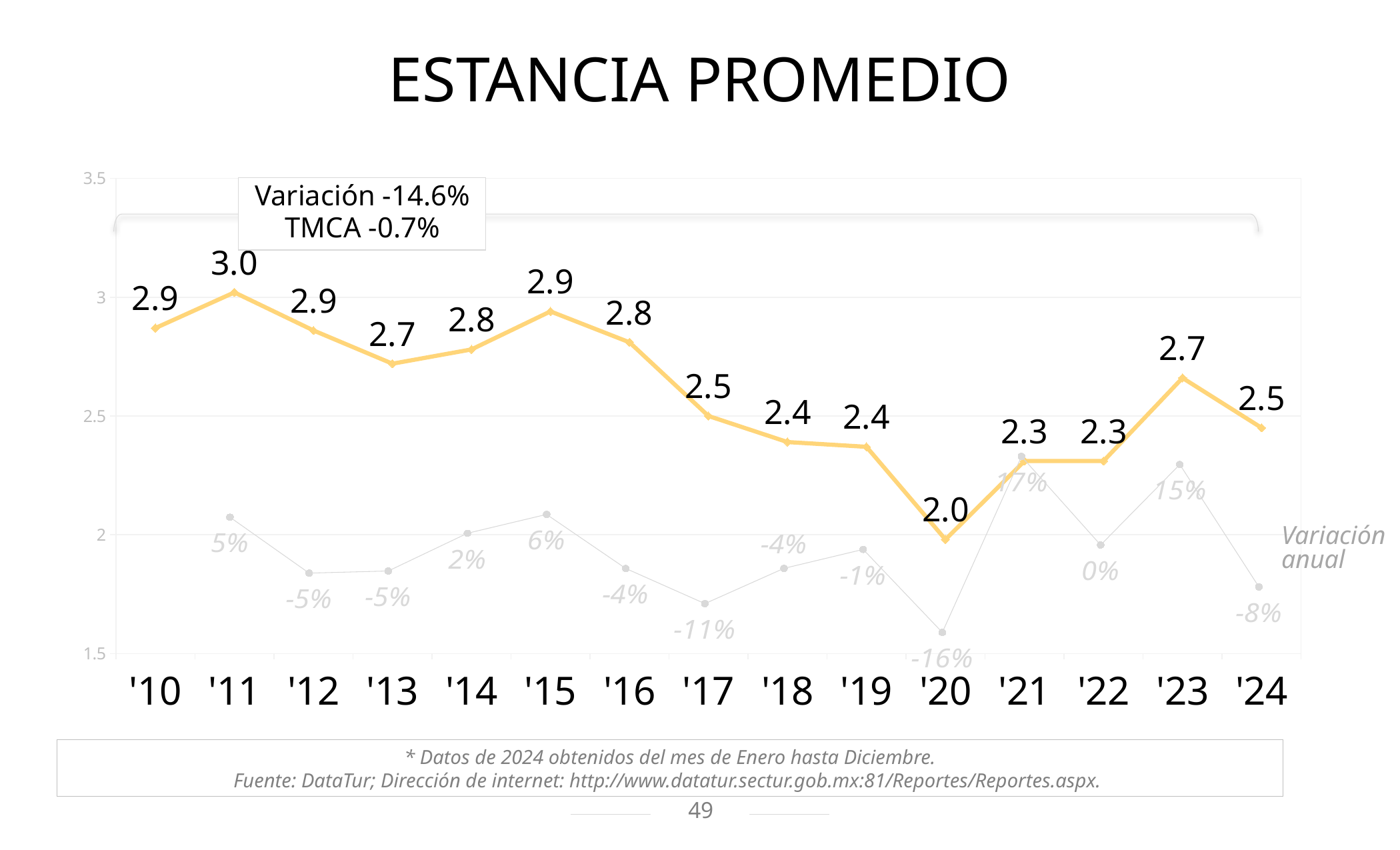
Which year has the highest value on the main line? '11 What is the annual variation (Variación anual) shown for '21? 17% What is the value shown for '23? 2.7 How many years are plotted on the x axis? 15 Which year has the lowest value on the main line? '20 What overall variation (Variación) is stated in the text box on the chart? -14.6% What is the annual variation shown for '20? -16% What is the difference between the values for '11 and '20? 1.0 What type of chart is shown? line chart What is the value shown for '11 on the main line? 3.0 What is the average stay (estancia promedio) value shown for '20? 2.0 Which is larger, the value for '15 or the value for '17? '15